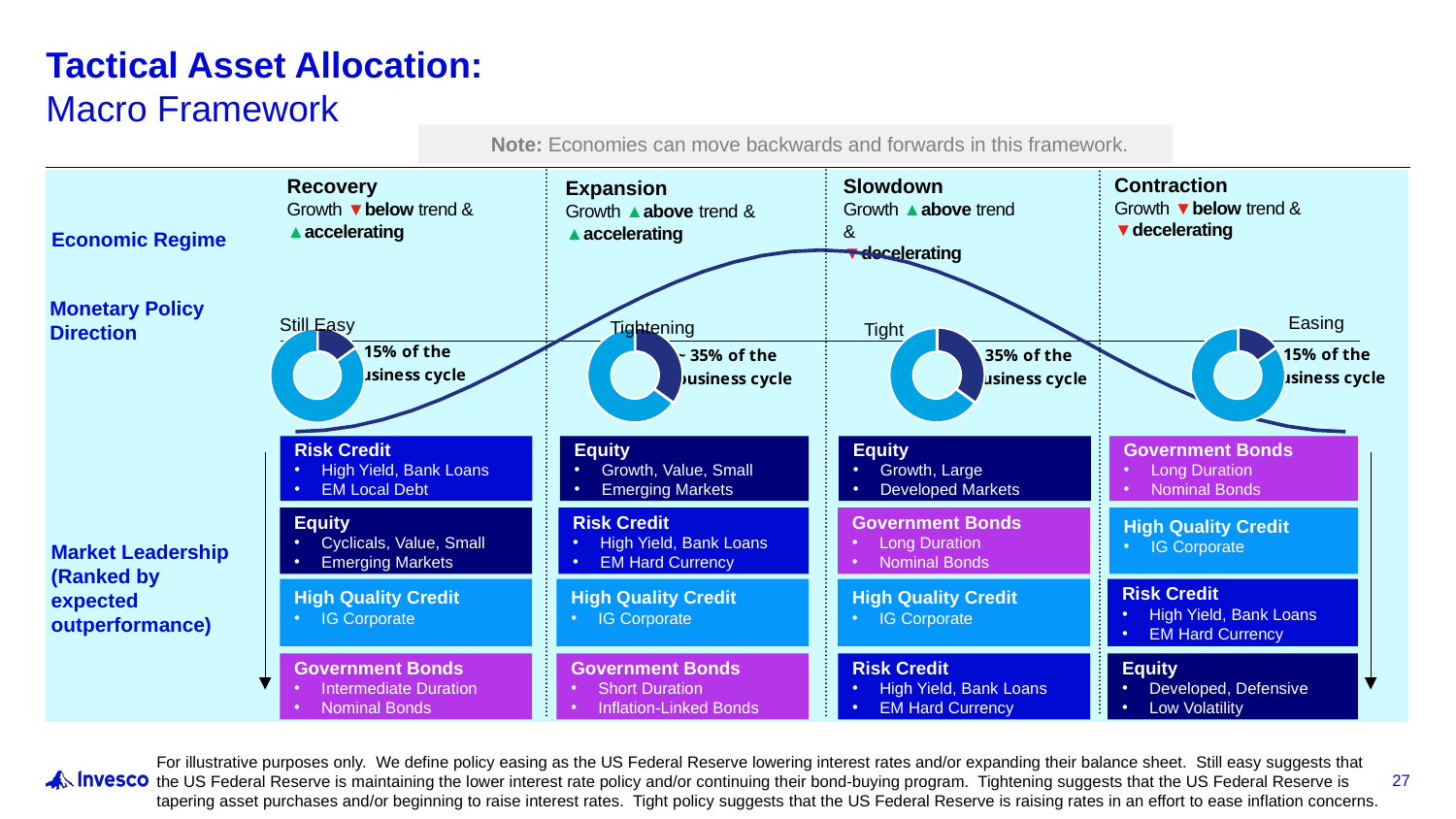
According to the Expansion donut chart, what share of the business cycle does the Expansion regime represent? 35% Which economic regime's donut chart is labelled with the monetary policy direction 'Tight'? Slowdown According to the Slowdown donut chart, what share of the business cycle does the Slowdown regime represent? 35% What monetary policy direction is shown above the Contraction donut chart? Easing Which represents a larger share of the business cycle, Expansion or Recovery? Expansion How many donut charts are shown on the slide? 4 Which represents a smaller share of the business cycle, Slowdown or Contraction? Contraction Is the share of the business cycle shown for the Expansion regime greater or less than 20%? greater According to the Contraction donut chart, what share of the business cycle does the Contraction regime represent? 15% What kind of chart is shown beneath each economic regime on the slide? Pie (donut) chart According to the Recovery donut chart, what share of the business cycle does the Recovery regime represent? 15%